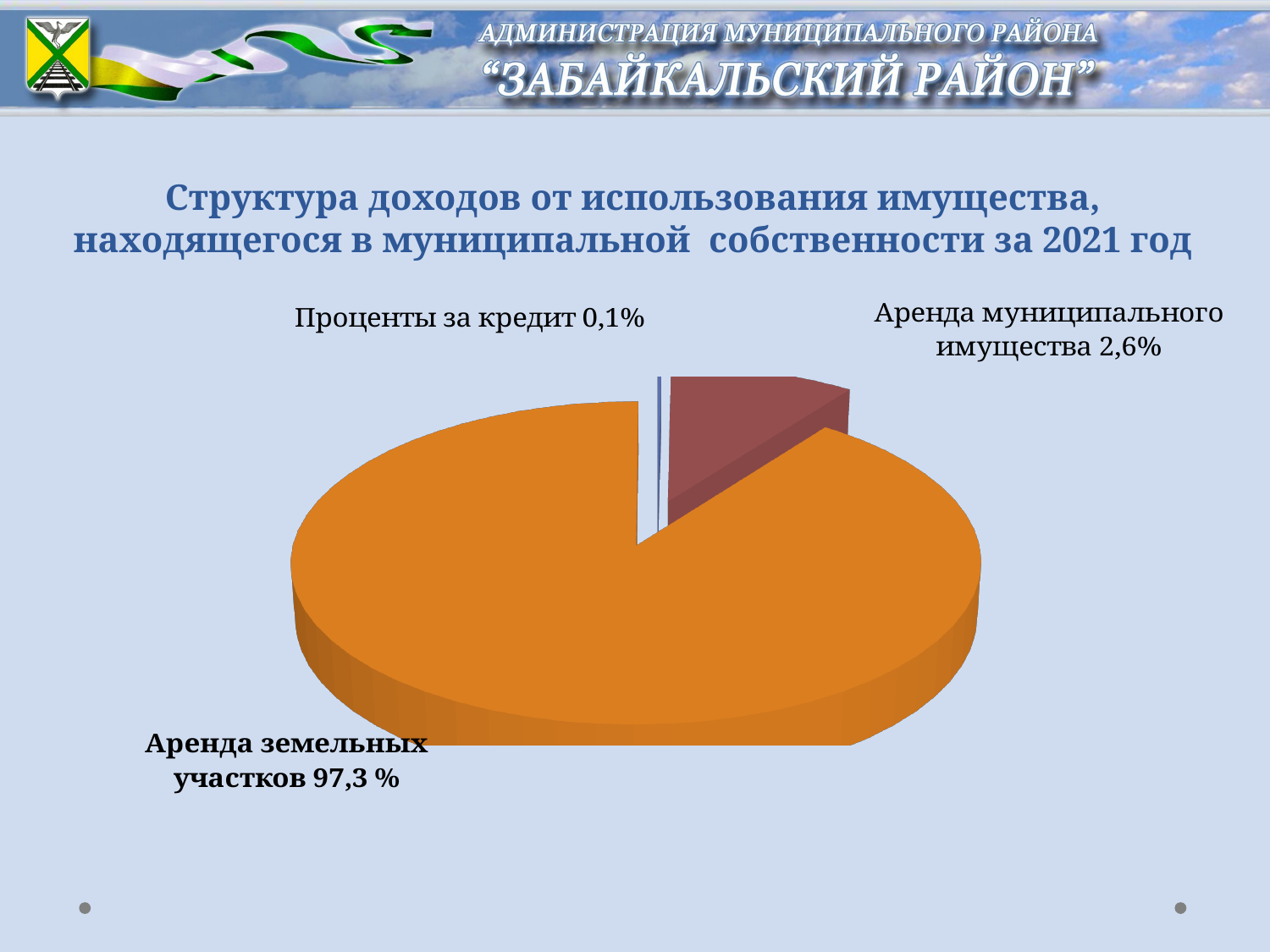
What share of the pie does "Аренда муниципального имущества" have? 2,6% What colour is the slice for "Аренда земельных участков"? Orange Which category has the smallest slice of the pie? Проценты за кредит What is the difference in percentage points between the share for "Аренда земельных участков" and the share for "Аренда муниципального имущества"? 94,7 What share of the pie does "Проценты за кредит" have? 0,1% Which is larger: the share for "Аренда муниципального имущества" or the share for "Проценты за кредит"? Аренда муниципального имущества What kind of chart is shown on the slide? Pie chart What is the title of the chart on the slide? Структура доходов от использования имущества, находящегося в муниципальной собственности за 2021 год What share of the pie does "Аренда земельных участков" have? 97,3 % How many slices does the pie chart have? 3 What is the difference in percentage points between the share for "Аренда муниципального имущества" and the share for "Проценты за кредит"? 2,5 Which category has the largest slice of the pie? Аренда земельных участков